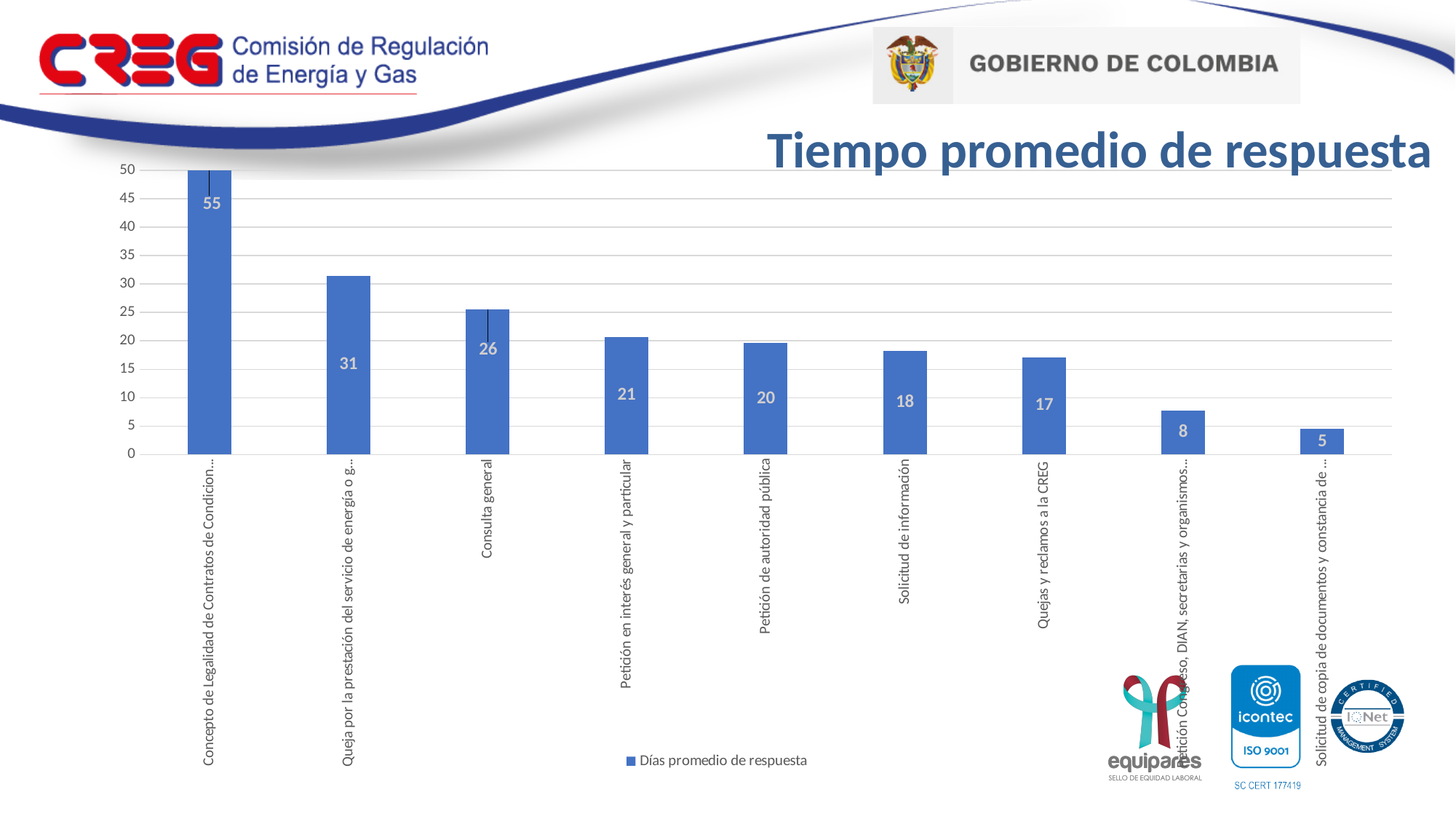
What kind of chart is shown on the slide? Bar chart How many bars does the chart show? 9 What is the value of the tallest bar, the first one on the left? 55 Which is larger, the value for Petición de autoridad pública or the value for Quejas y reclamos a la CREG? Petición de autoridad pública What is the value for Consulta general? 26 What is the value for Petición de autoridad pública? 20 What is the value for Quejas y reclamos a la CREG? 17 What is the legend entry of the chart? Días promedio de respuesta What is the difference between the values for Consulta general and Solicitud de información? 8 Which category has the lowest value? Solicitud de copia de documentos y constancia de ... What is the value for Petición en interés general y particular? 21 What is the value for Solicitud de información? 18